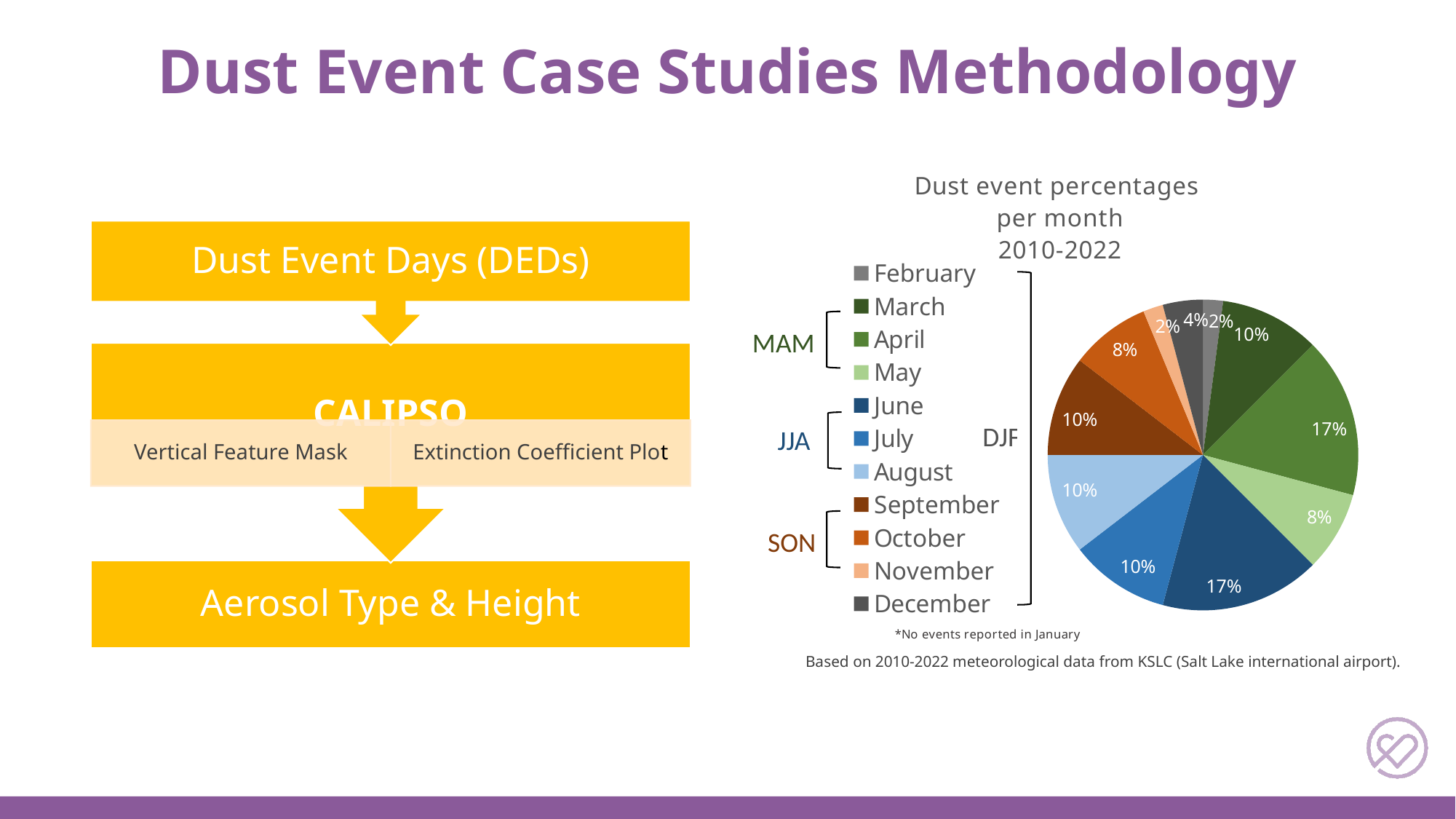
What percentage of dust events occurred in April? 17% What percentage of dust events occurred in December? 4% What percentage of dust events occurred in June? 17% Which month has a larger share of dust events, October or December? October Which month has a larger share of dust events, April or May? April What percentage of dust events occurred in September? 10% What type of chart is shown on the slide? pie chart What percentage of dust events occurred in May? 8% What is the difference between the June and July percentages? 7% What is the title of the pie chart? Dust event percentages per month 2010-2022 How many months are listed in the legend of the pie chart? 11 Which month is noted as having no events reported? January